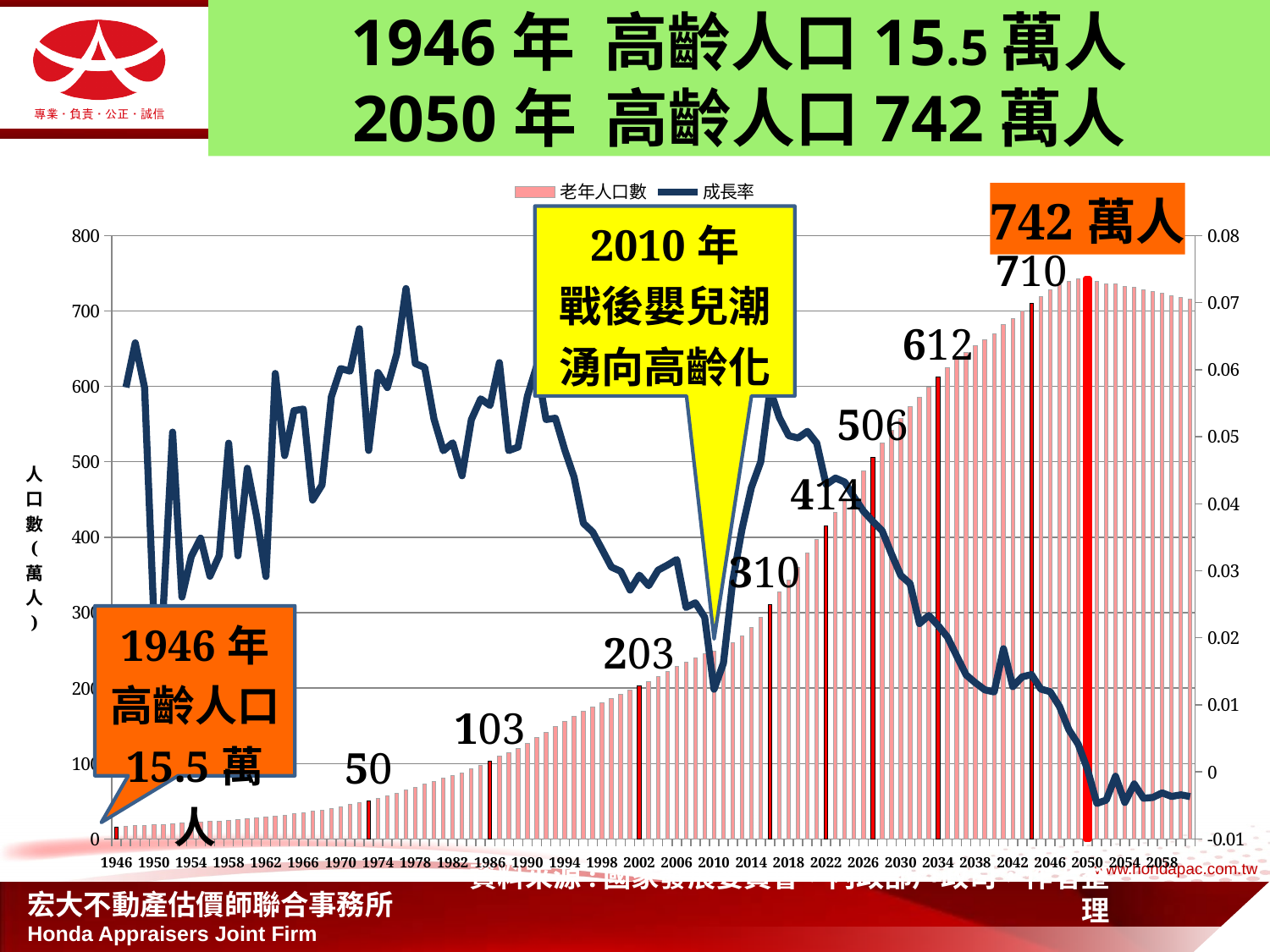
Which year has the highest labelled elderly population bar? 2050 Do the elderly population bars generally rise or fall from 1946 to 2050? Rise Is the growth rate (成長率) in 2058 greater or less than 0? less Which series is drawn as a line in the chart? 成長率 What is the elderly population shown for 1946? 15.5 萬人 What kind of chart is shown on the slide? A combination bar and line chart What is the difference between the bars labelled 710 and 612? 98 What is the difference between the elderly population in 2050 (742) and in 1946 (15.5)? 726.5 萬人 How many series does the chart legend list? 2 What is the elderly population (老年人口數) shown for 2050? 742 萬人 Is the growth rate (成長率) in 2010 greater or less than 0.02? less What is the elderly population labelled on the bar for 2002? 203